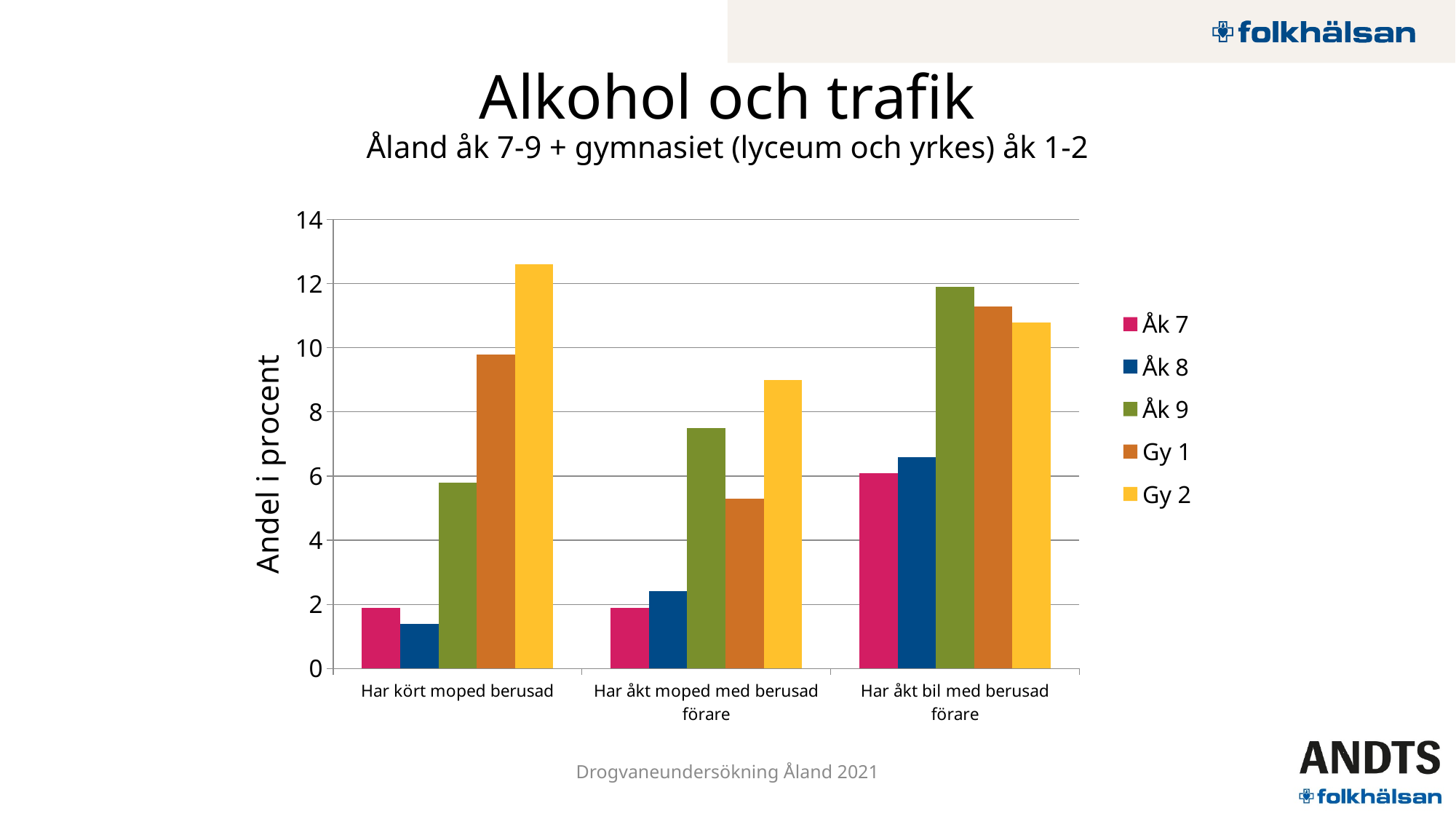
Is the value for Åk 9 in "Har åkt moped med berusad förare" greater or less than 8? less What kind of chart is shown on the slide? bar chart Which series has the highest value for "Har åkt bil med berusad förare"? Åk 9 What is the label of the chart's y axis? Andel i procent How many categories are shown on the x axis of the chart? 3 How many series does the chart's legend list? 5 Is the value for Gy 2 in "Har kört moped berusad" greater or less than 12? greater Which series has the lowest value for "Har kört moped berusad"? Åk 8 Which series has the highest value for "Har kört moped berusad"? Gy 2 Which series has the lowest value for "Har åkt bil med berusad förare"? Åk 7 For "Har åkt moped med berusad förare", which is larger: Gy 1 or Gy 2? Gy 2 Is the value for Åk 8 in "Har kört moped berusad" greater or less than 2? less